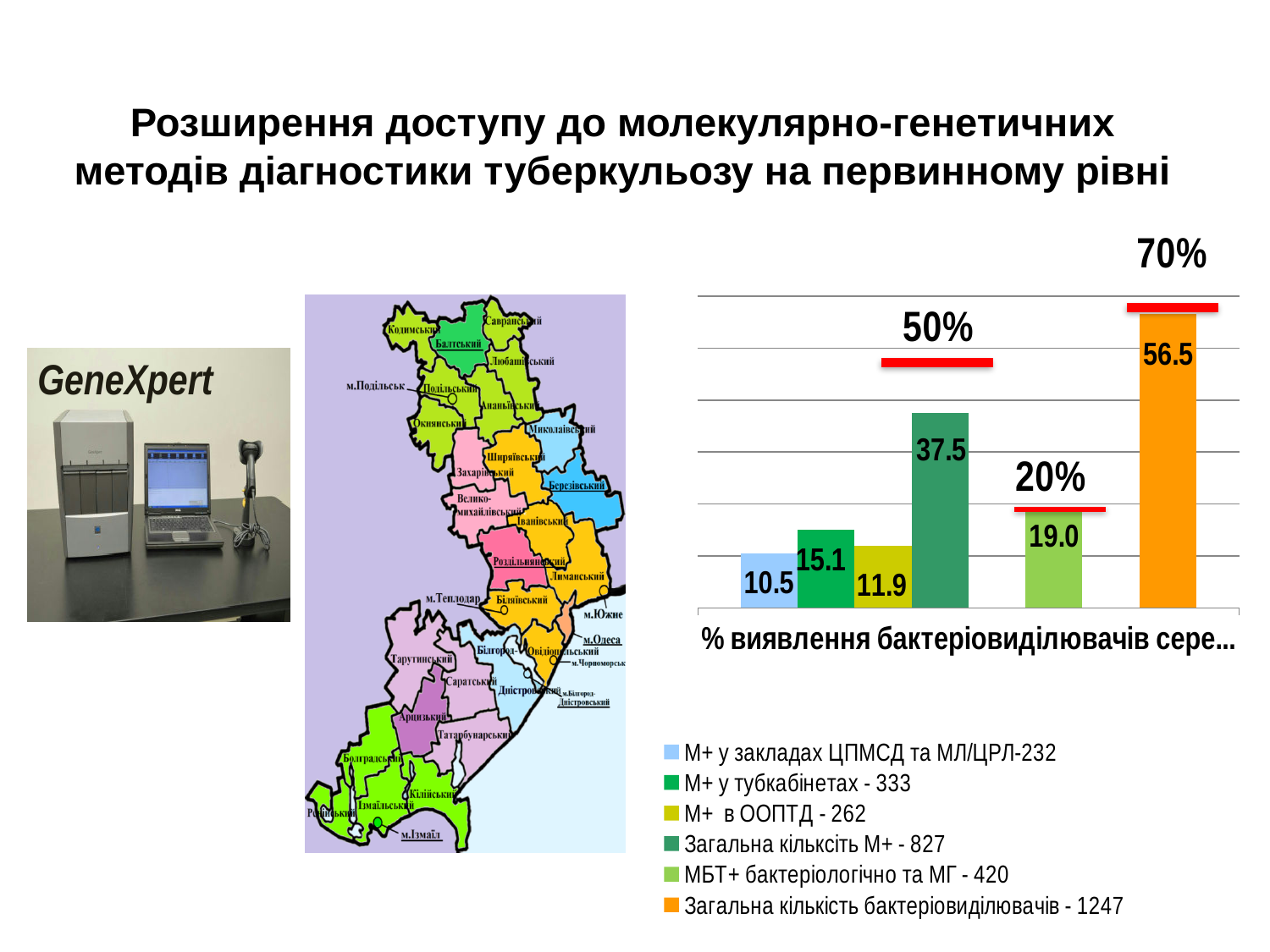
What is the difference between the value for "Загальна кількість бактеріовиділювачів - 1247" and the value for "Загальна кількість М+ - 827"? 19.0 Which series has the highest value in the chart? Загальна кількість бактеріовиділювачів - 1247 What kind of chart is shown on the slide? bar chart What is the value for "М+ у тубкабінетах - 333"? 15.1 How many series does the chart legend list? 6 What is the value for "М+ у закладах ЦПМСД та МЛ/ЦРЛ-232"? 10.5 How many bars are plotted in the chart? 6 Which is larger: the value for "М+ у тубкабінетах - 333" or the value for "М+ в ООПТД - 262"? М+ у тубкабінетах - 333 What is the value for "МБТ+ бактеріологічно та МГ - 420"? 19.0 What is the value for "М+ в ООПТД - 262"? 11.9 What is the value for "Загальна кількість М+ - 827"? 37.5 Which series has the lowest value in the chart? М+ у закладах ЦПМСД та МЛ/ЦРЛ-232